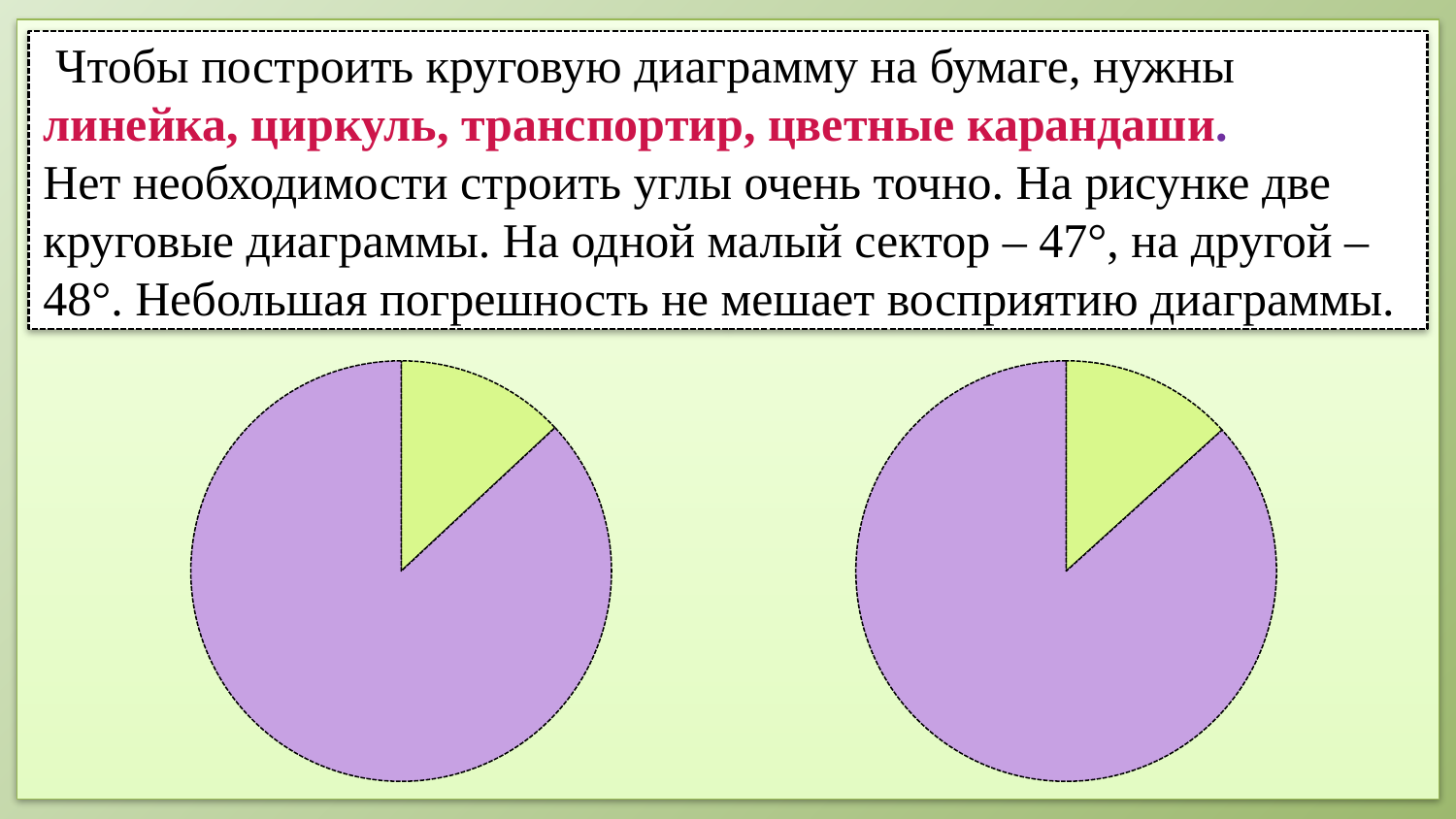
In the left pie chart, how many slices are there? 2 In the right pie chart, which slice is larger, the purple one or the green one? the purple one In the left pie chart, is the green slice greater or less than half of the pie? less In the right pie chart, is the purple slice greater or less than half of the pie? greater What colour is the small sector in both pie charts? green According to the slide text, what are the angles of the small sectors in the two pie charts? 47° and 48° What kind of chart is the left chart on the slide? pie chart In the right pie chart, how many slices are there? 2 What kind of chart is the right chart on the slide? pie chart How many pie charts are shown on the slide? 2 In the left pie chart, which slice is larger, the purple one or the green one? the purple one